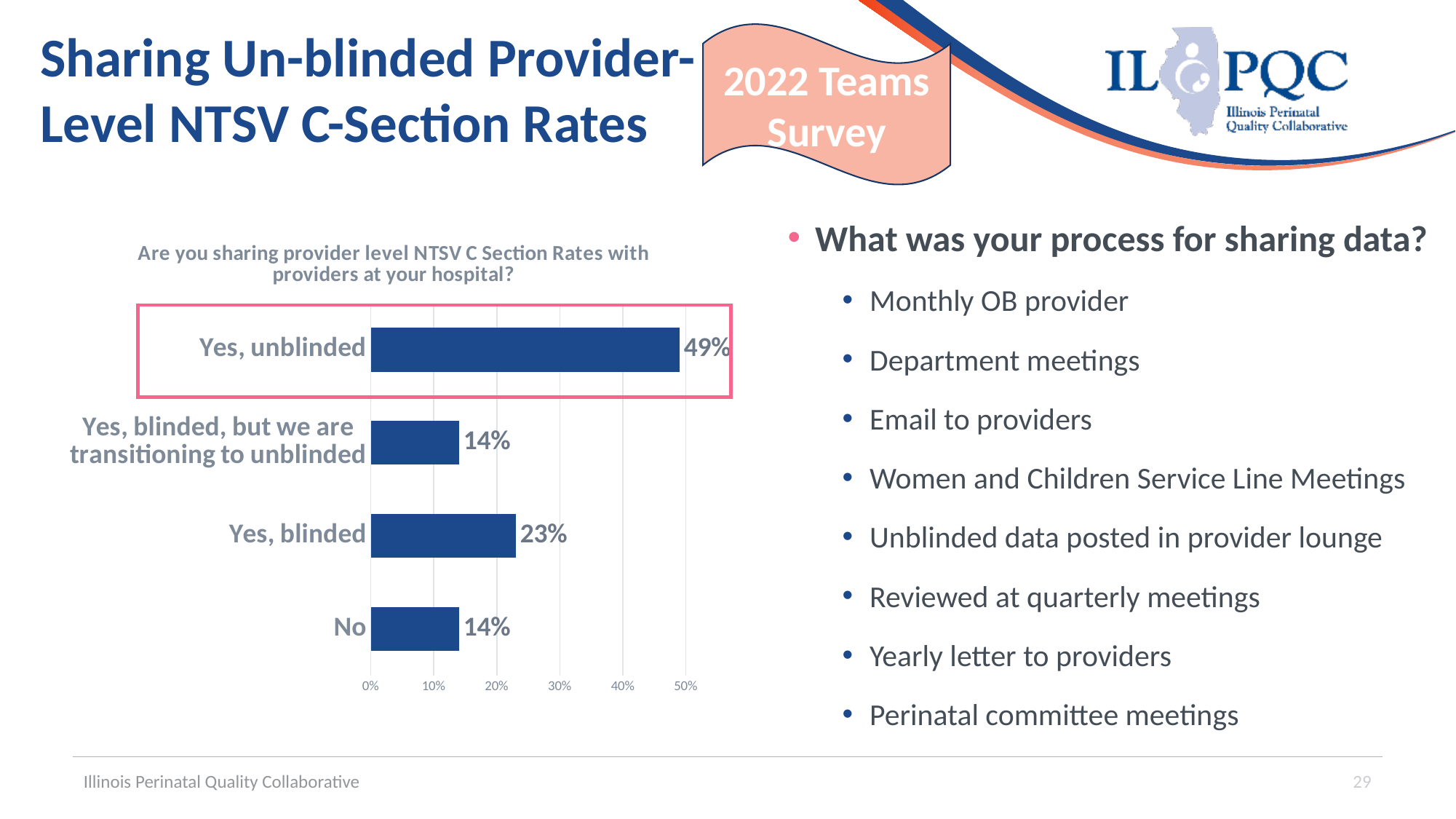
How many response categories are shown in the chart? 4 What percentage of respondents answered "Yes, unblinded"? 49% What percentage of respondents answered "Yes, blinded"? 23% Which response category has the highest percentage? Yes, unblinded Which bar in the chart is outlined with a pink box? Yes, unblinded What kind of chart is shown on the slide? Bar chart What percentage of respondents answered "No"? 14% What is the title of the chart? Are you sharing provider level NTSV C Section Rates with providers at your hospital? Is the value for "Yes, blinded" greater or less than 20%? greater Which is larger, the value for "Yes, blinded" or the value for "No"? Yes, blinded What percentage of respondents answered "Yes, blinded, but we are transitioning to unblinded"? 14% What is the difference in percentage points between "Yes, unblinded" and "Yes, blinded"? 26